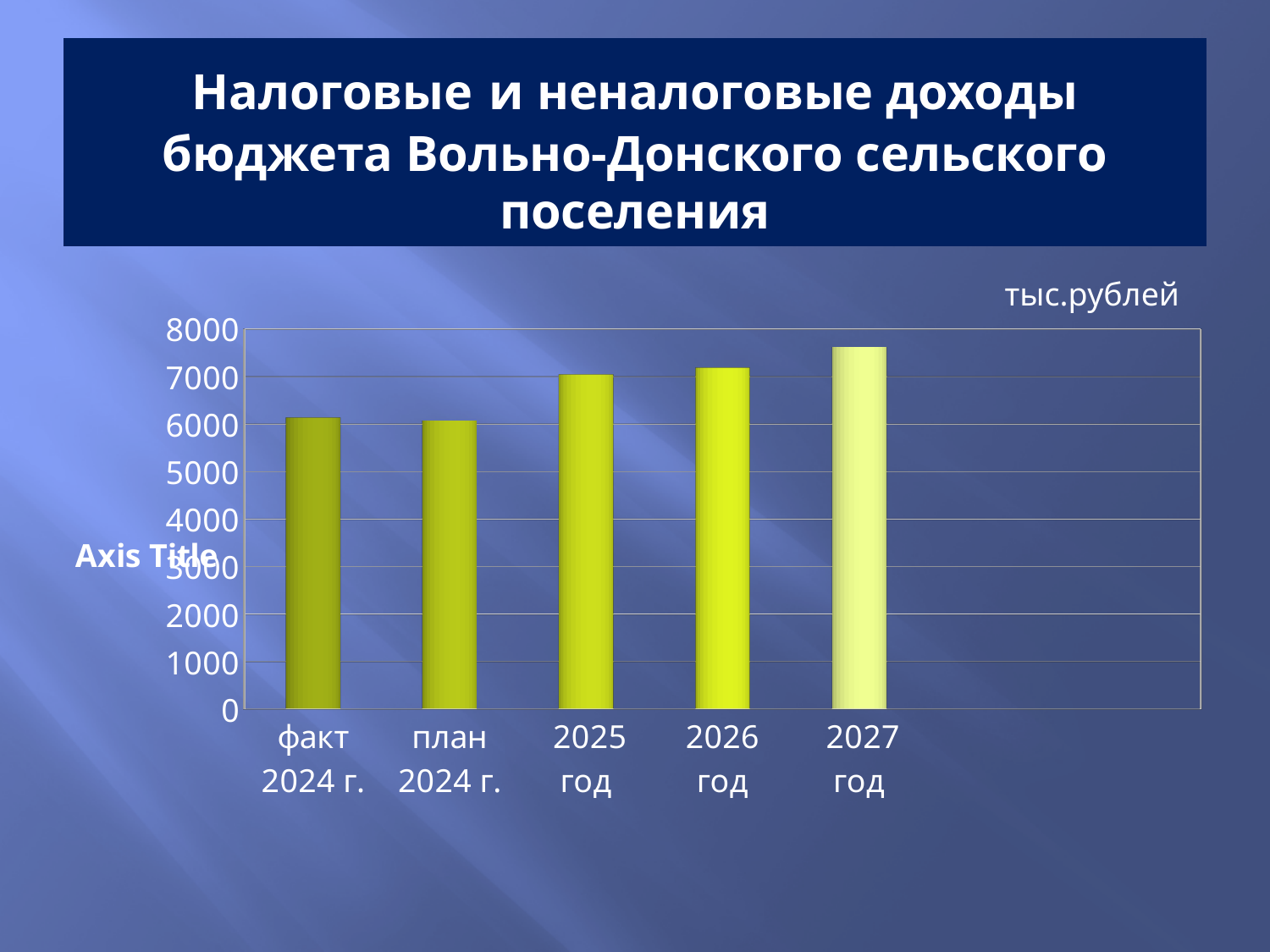
Is the value for 2026 год greater or less than 8000? less What unit of measurement is indicated above the chart? тыс.рублей Is the value for план 2024 г. greater or less than 5000? greater How many categories are plotted on the x axis of the chart? 5 Is the value for факт 2024 г. greater or less than 7000? less Which category has the highest value in the chart? 2027 год What kind of chart is shown on the slide? bar chart Which is larger, the value for 2025 год or the value for план 2024 г.? 2025 год Do the values rise or fall from 2025 год to 2027 год? rise Which is larger, the value for 2027 год or the value for факт 2024 г.? 2027 год